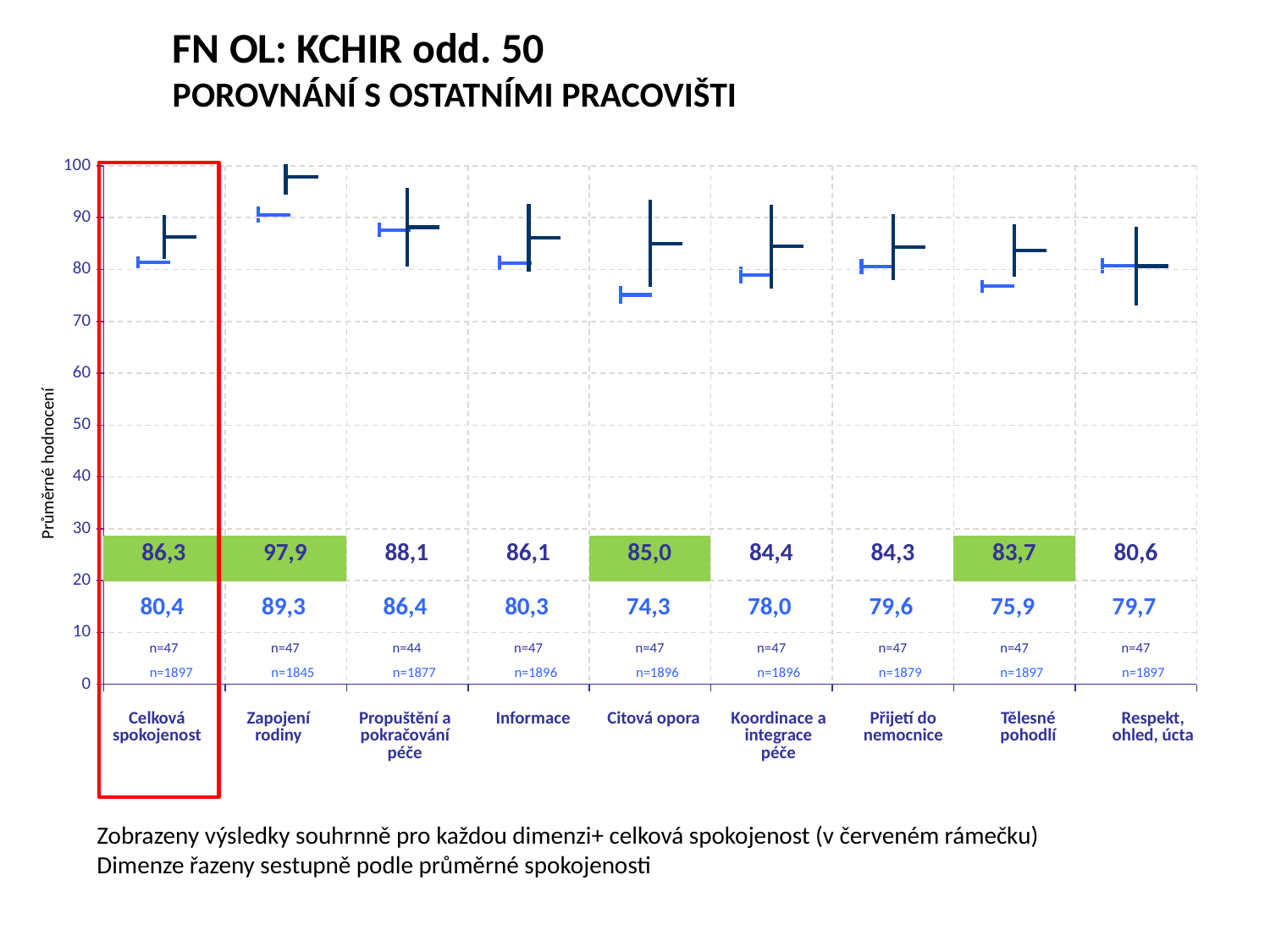
Which has the larger dark blue (upper row) value: Propuštění a pokračování péče or Informace? Propuštění a pokračování péče Which category has the lowest dark blue (upper row) value? Respekt, ohled, úcta What is the difference between the dark blue and light blue values for Zapojení rodiny? 8,6 Which category has the highest dark blue (upper row) value? Zapojení rodiny Which category is enclosed in the red frame? Celková spokojenost Which category has the lowest light blue (lower row) value? Citová opora What is the difference between the dark blue and light blue values for Celková spokojenost? 5,9 What is the light blue (lower row) value for Respekt, ohled, úcta? 79,7 What is the dark blue (upper row) value for Zapojení rodiny? 97,9 How many categories are shown on the x axis? 9 What is the first n value printed under Propuštění a pokračování péče? n=44 What is the light blue (lower row) value for Citová opora? 74,3